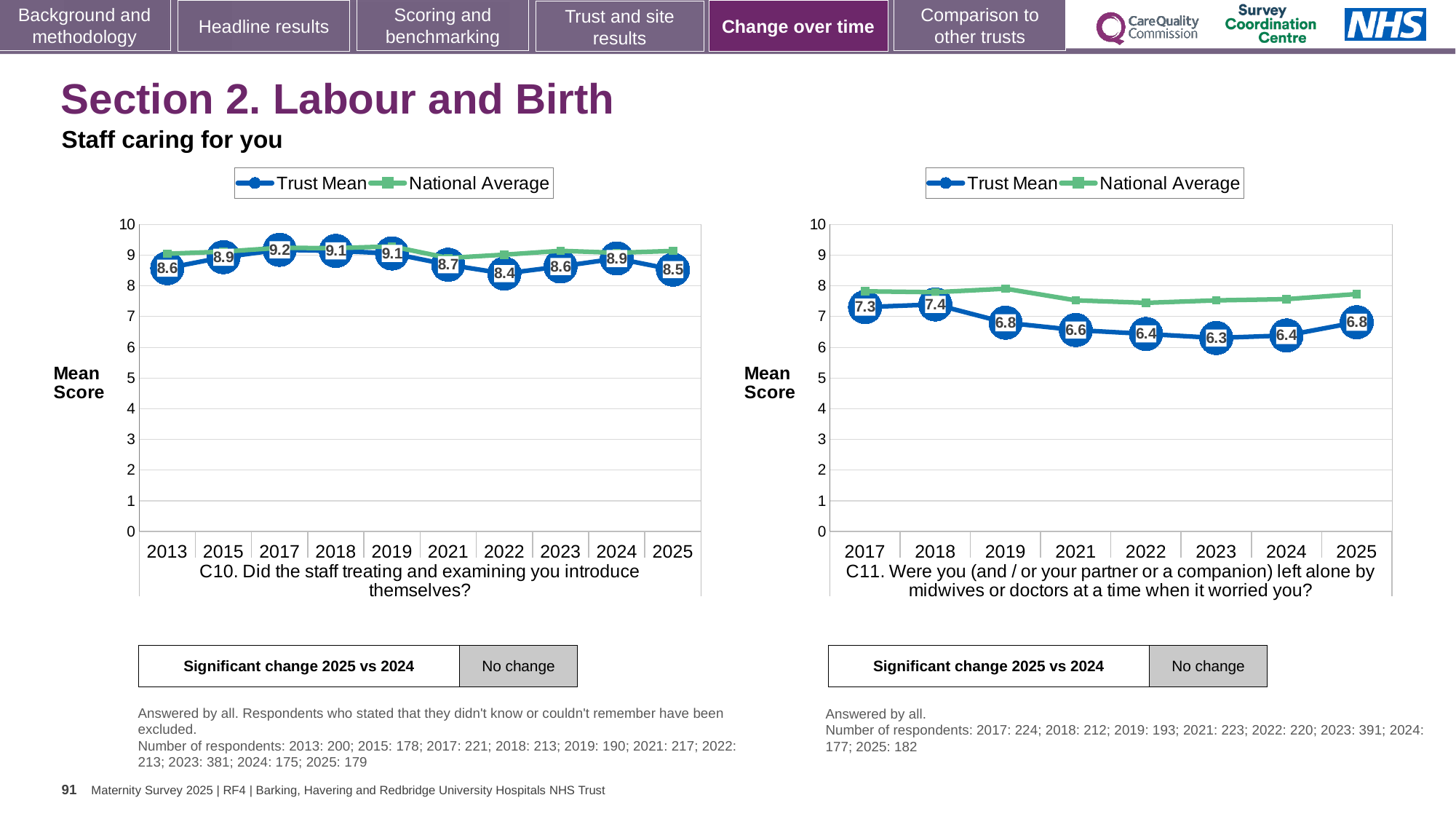
In the C10 chart (left), what is the Trust Mean for 2022? 8.4 In the C10 chart (left), what is the Trust Mean for 2017? 9.2 In the C11 chart (right), which year has the highest Trust Mean? 2018 What type of chart is the C10 chart (left)? Line chart In the C11 chart (right), what is the Trust Mean for 2023? 6.3 In the C10 chart (left), what is the difference between the Trust Mean in 2017 and in 2025? 0.7 In the C11 chart (right), what is the difference between the Trust Mean in 2017 and in 2022? 0.9 In the C10 chart (left), which year has the lowest Trust Mean? 2022 How many series does the legend of the C11 chart (right) list? 2 In the C10 chart (left), how many years are shown on the x axis? 10 In the C11 chart (right), is the National Average for 2025 greater or less than 7? greater In the C11 chart (right), is the Trust Mean for 2018 larger or smaller than the Trust Mean for 2025? larger